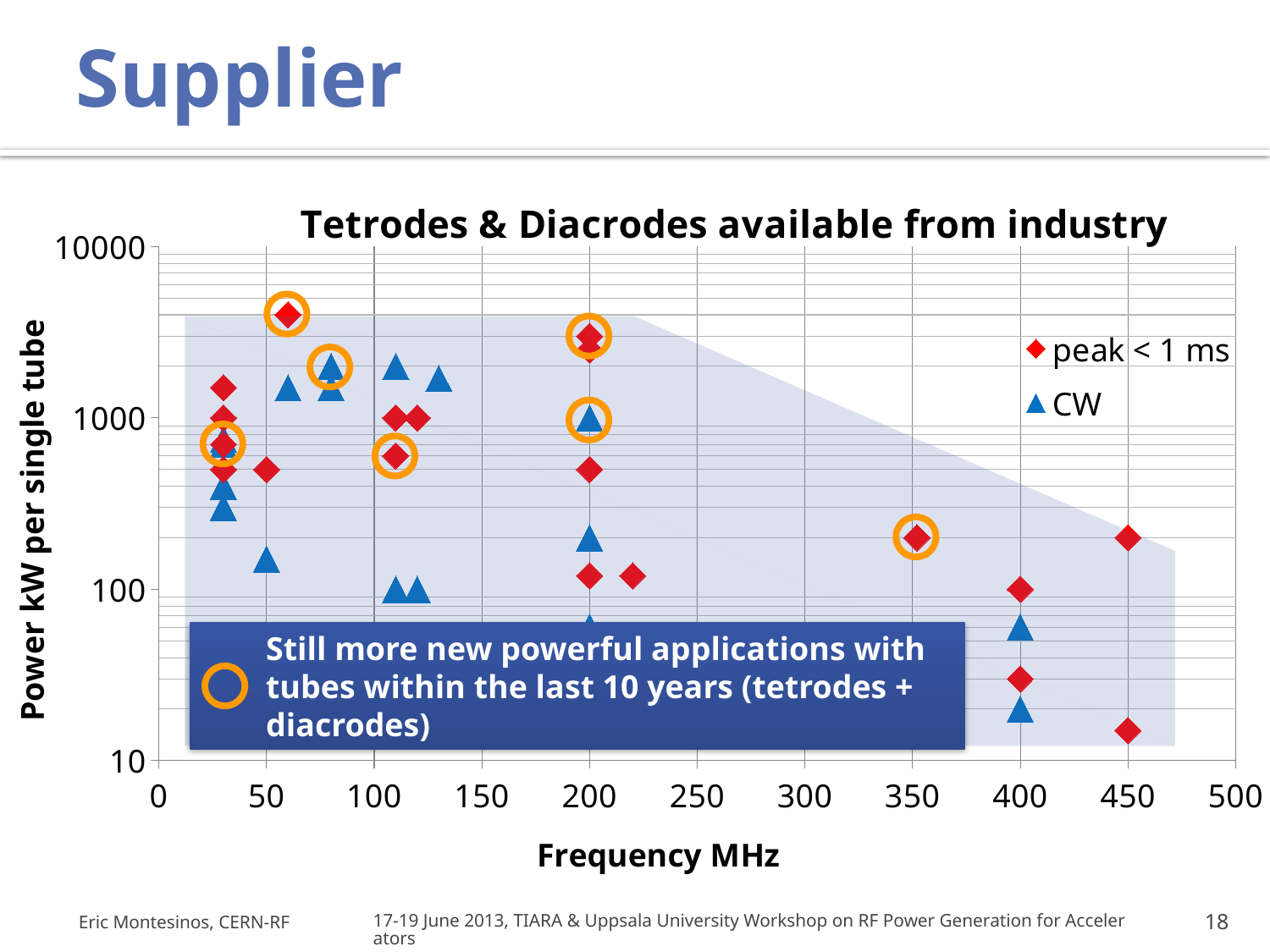
What is the label of the x axis? Frequency MHz Does the maximum available power per tube generally rise or fall as frequency increases along the x axis? fall Is the highest 'peak < 1 ms' point at 200 MHz greater or less than 1000 kW? greater What kind of chart is shown on the slide? Scatter chart What are the two series named in the legend? peak < 1 ms and CW Is the lowest 'peak < 1 ms' point at 450 MHz greater or less than 100 kW? less What is the title of the chart? Tetrodes & Diacrodes available from industry Which series has the highest plotted point on the chart, 'peak < 1 ms' or CW? peak < 1 ms Is the lowest CW point at 400 MHz greater or less than 100 kW? less How many series does the legend list? 2 What is the label of the y axis? Power kW per single tube